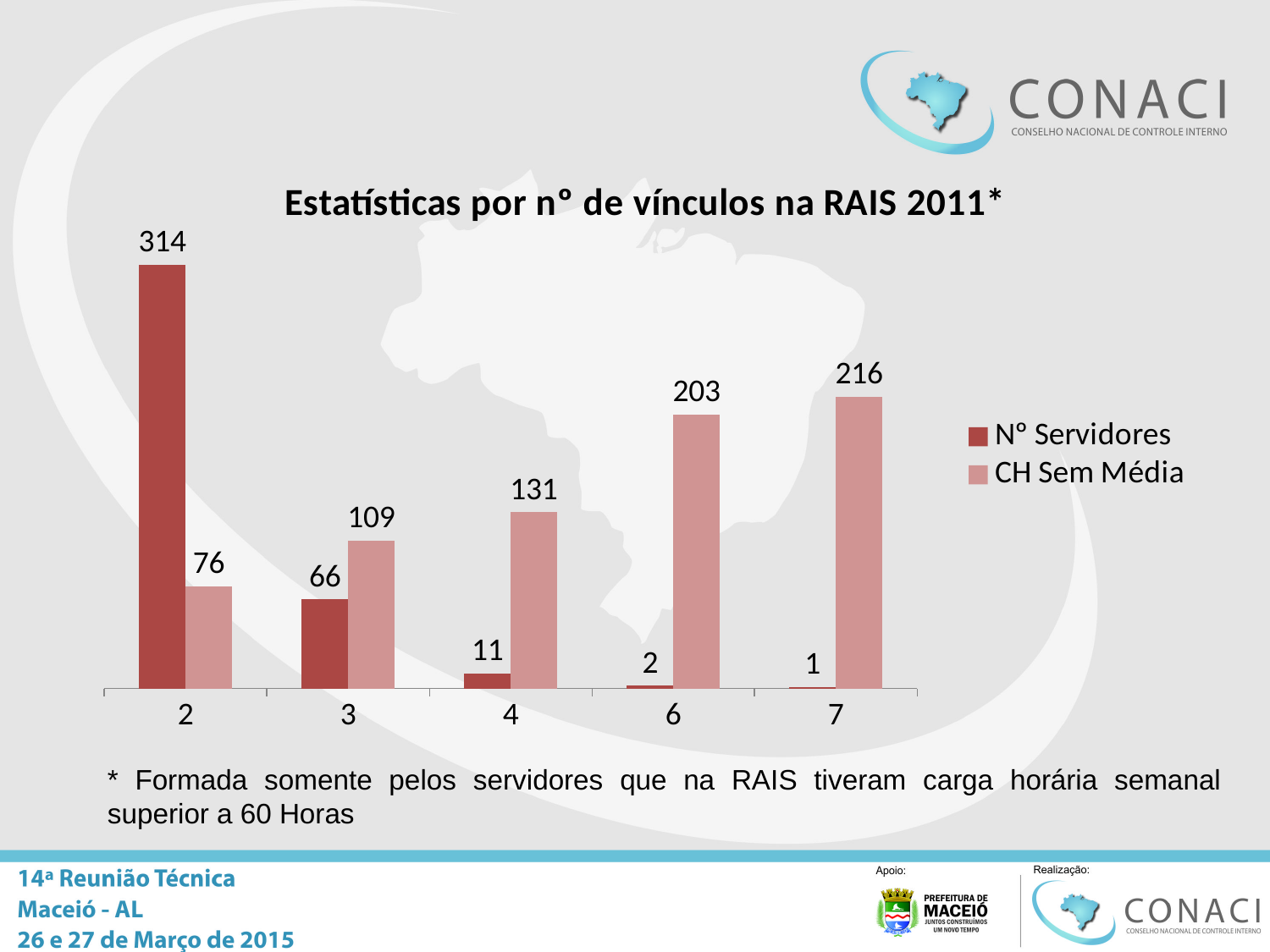
Which category has the lowest Nº Servidores value? 7 What is the value of Nº Servidores for category 2? 314 What kind of chart is shown on the slide? Bar chart Do the CH Sem Média values rise or fall from category 2 to category 7? Rise What is the value of CH Sem Média for category 6? 203 How many categories are shown on the x axis? 5 What is the difference between Nº Servidores and CH Sem Média for category 2? 238 What is the value of Nº Servidores for category 4? 11 How many series does the legend list? 2 Which category has the highest CH Sem Média value? 7 What is the title of the chart? Estatísticas por nº de vínculos na RAIS 2011* Which is larger for category 3: Nº Servidores or CH Sem Média? CH Sem Média